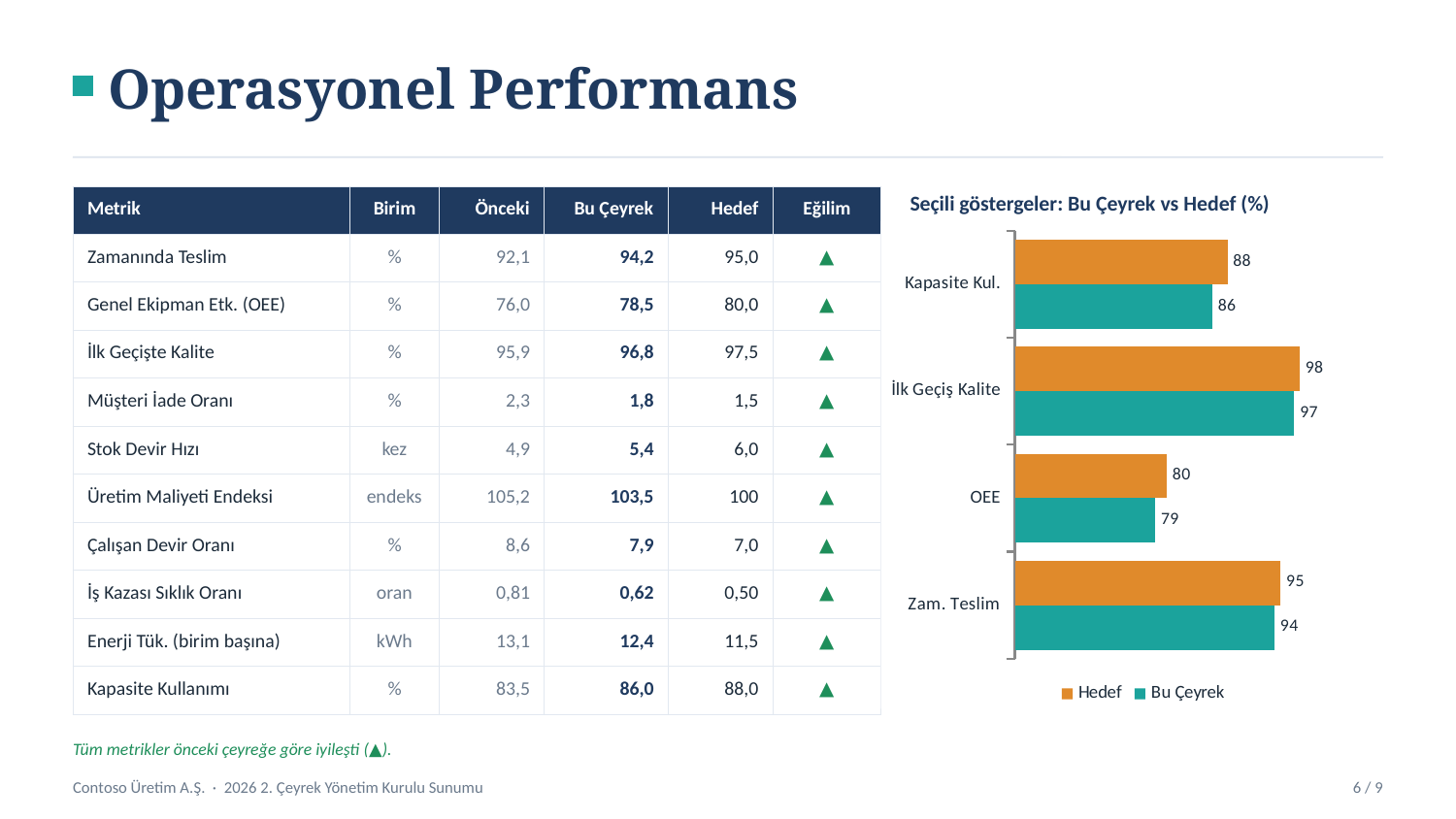
What type of chart is shown on the slide? bar chart How many categories are shown in the chart? 4 Which is larger for Zam. Teslim: the Hedef value or the Bu Çeyrek value? Hedef Which category has the lowest Bu Çeyrek value in the chart? OEE What is the Bu Çeyrek value for İlk Geçiş Kalite in the chart? 97 How many series does the chart legend list? 2 What is the Hedef value for Zam. Teslim in the chart? 95 What is the difference between the Hedef and Bu Çeyrek values for Kapasite Kul.? 2 Which category has the highest Hedef value in the chart? İlk Geçiş Kalite What is the Bu Çeyrek value for OEE in the chart? 79 What is the title of the chart? Seçili göstergeler: Bu Çeyrek vs Hedef (%) What is the Hedef value for Kapasite Kul. in the chart? 88